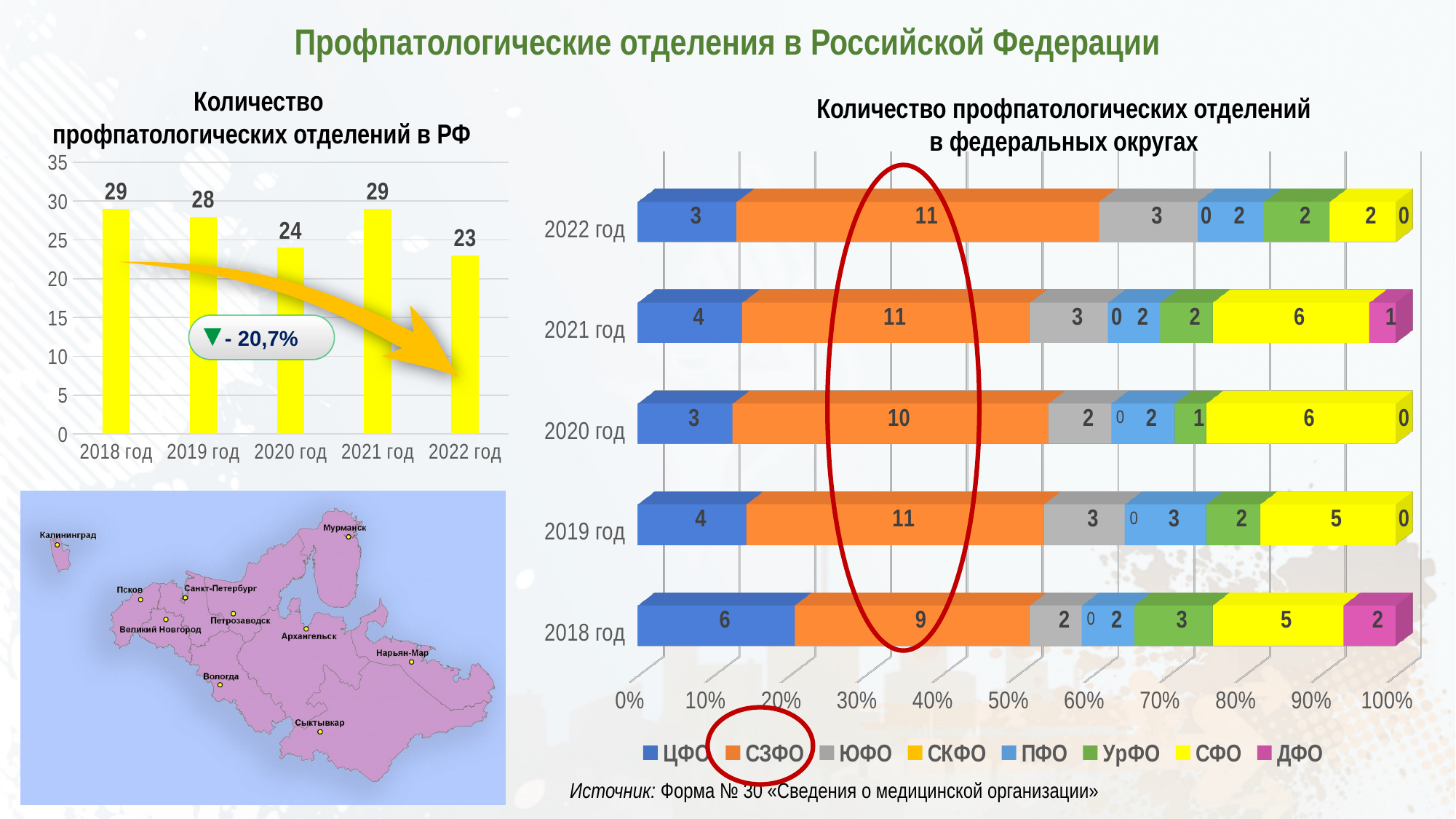
On the right chart 'Количество профпатологических отделений в федеральных округах', how many series does the legend list? 8 On the right chart 'Количество профпатологических отделений в федеральных округах', what is the difference between ЦФО in 2018 год and ЦФО in 2022 год? 3 On the left chart 'Количество профпатологических отделений в РФ', what is the difference between the values for 2021 год and 2022 год? 6 On the right chart 'Количество профпатологических отделений в федеральных округах', which is larger in 2019 год: ЦФО or ПФО? ЦФО On the right chart 'Количество профпатологических отделений в федеральных округах', what is the total of the stacked bar for 2020 год? 24 On the left chart 'Количество профпатологических отделений в РФ', what is the value for 2020 год? 24 What kind of chart is the left chart 'Количество профпатологических отделений в РФ'? bar chart On the left chart 'Количество профпатологических отделений в РФ', how many years are shown on the x axis? 5 On the right chart 'Количество профпатологических отделений в федеральных округах', what is the value for СЗФО in 2018 год? 9 On the left chart 'Количество профпатологических отделений в РФ', which year has the lowest value? 2022 год On the right chart 'Количество профпатологических отделений в федеральных округах', which legend entry is circled in red? СЗФО On the right chart 'Количество профпатологических отделений в федеральных округах', what is the value for СФО in 2021 год? 6